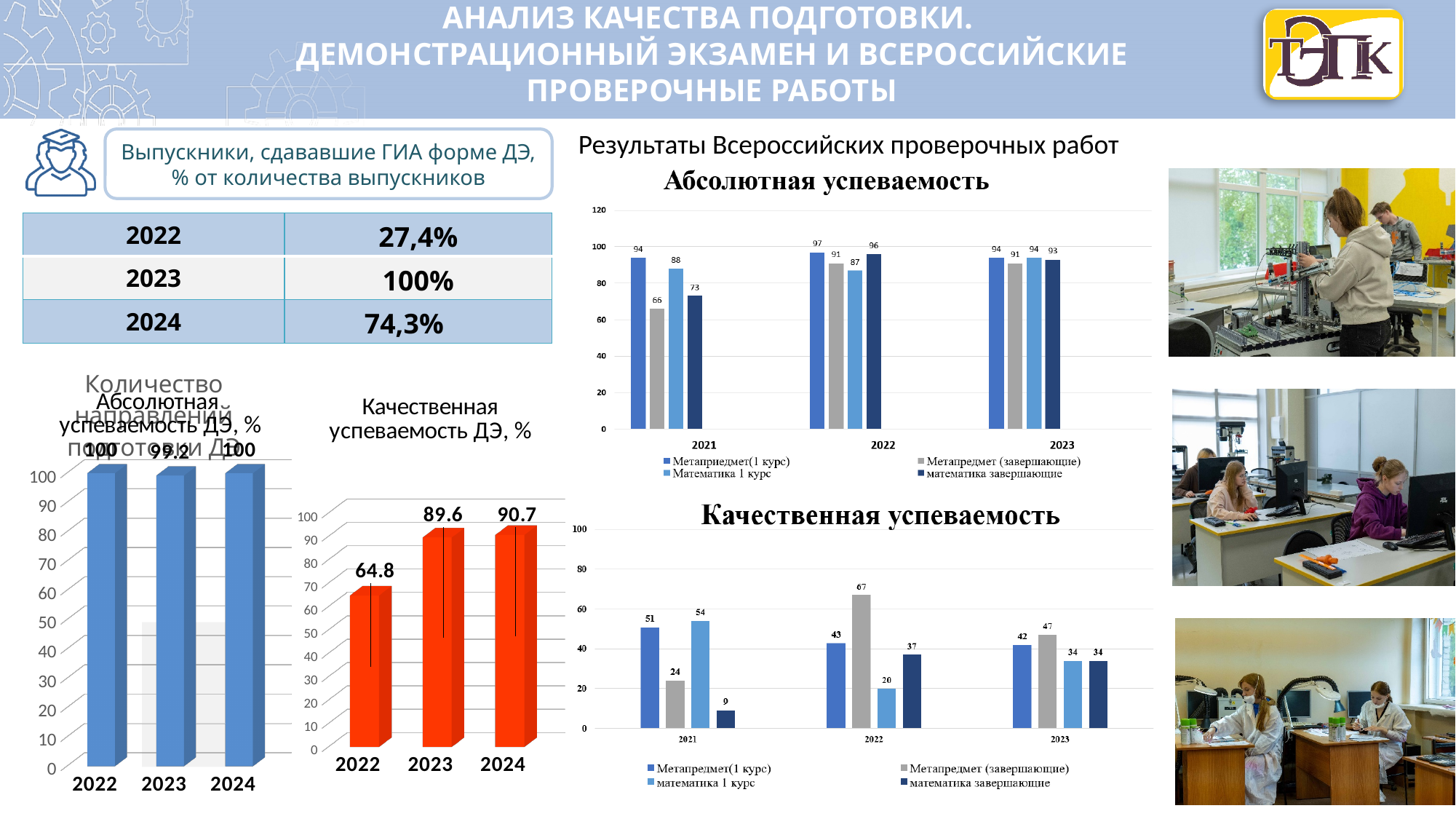
In the chart titled "Абсолютная успеваемость ДЭ, %", how many years are shown on the x axis? 3 In the chart titled "Абсолютная успеваемость" (top right), what is the value for "Метапредмет (завершающие)" in 2021? 66 In the chart titled "Качественная успеваемость ДЭ, %", which year has the highest value? 2024 In the chart titled "Абсолютная успеваемость" (top right), which series has the lowest value in 2021? Метапредмет (завершающие) In the chart titled "Качественная успеваемость" (bottom right), is the value for "Метапредмет(1 курс)" in 2021 larger or smaller than the value for "математика 1 курс" in 2021? smaller In the chart titled "Качественная успеваемость ДЭ, %", what is the value for 2022? 64.8 In the chart titled "Абсолютная успеваемость ДЭ, %", what is the value for 2023? 99.2 In the chart titled "Качественная успеваемость ДЭ, %", what is the difference between the 2023 and 2022 values? 24.8 In the chart titled "Абсолютная успеваемость" (top right), how many series does the legend list? 4 In the chart titled "Качественная успеваемость" (bottom right), which series has the highest value in 2022? Метапредмет (завершающие) What kind of chart is the one titled "Качественная успеваемость ДЭ, %"? bar chart In the chart titled "Качественная успеваемость" (bottom right), what is the value for "математика завершающие" in 2021? 9